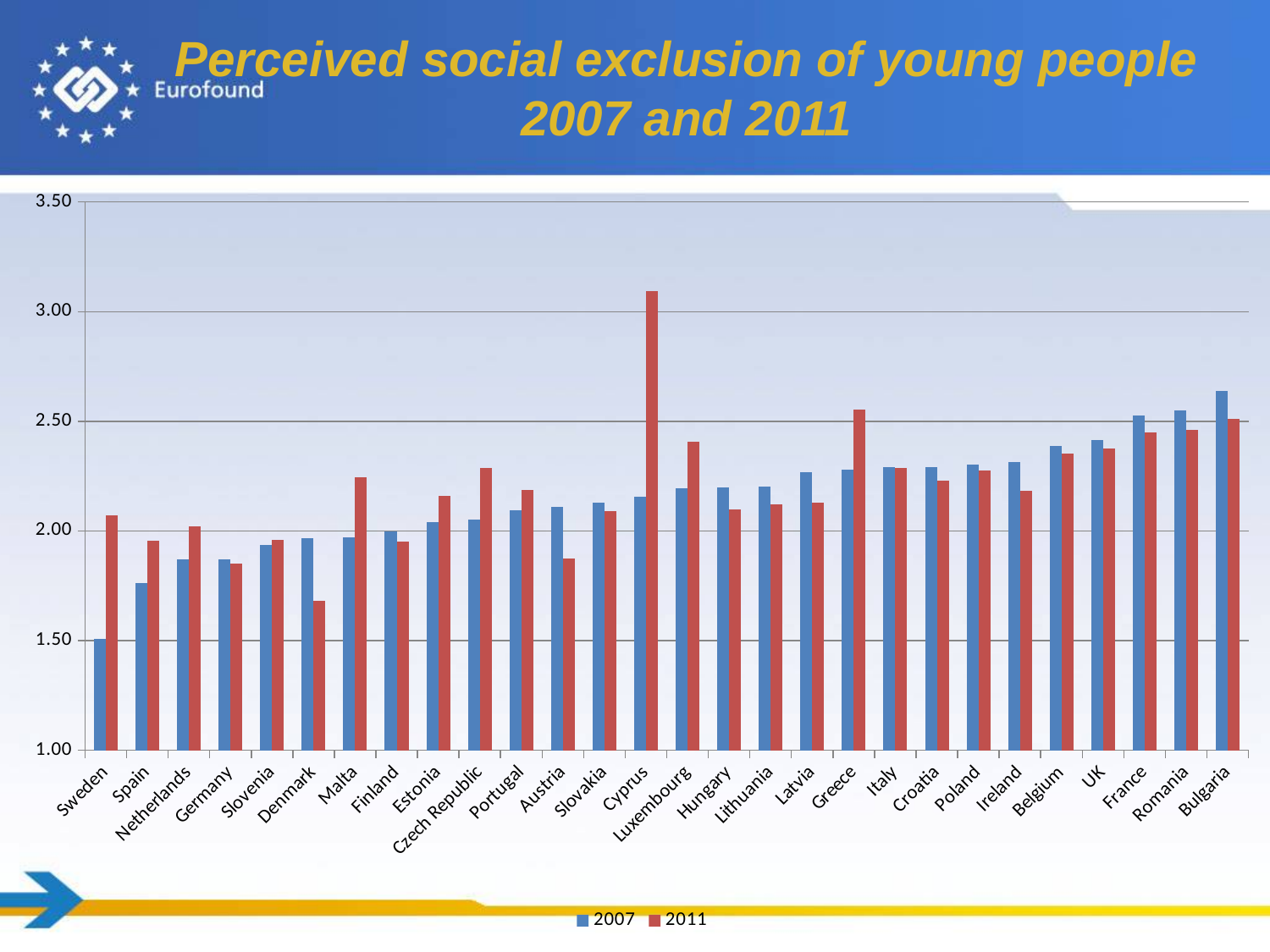
How many series does the legend list? 2 Is the 2011 value for Denmark greater or less than 2.00? less For Austria, which year has the larger value, 2007 or 2011? 2007 For Sweden, which year has the larger value, 2007 or 2011? 2011 Is the 2007 value for Bulgaria greater or less than 2.50? greater Is the 2011 value for Cyprus greater or less than 3.00? greater Do the 2007 values generally rise or fall from left to right along the x axis? Rise Which country has the highest 2011 value? Cyprus Which country has the highest 2007 value? Bulgaria What kind of chart is shown on the slide? Bar chart How many countries are shown on the x axis? 28 Which country has the lowest 2007 value? Sweden